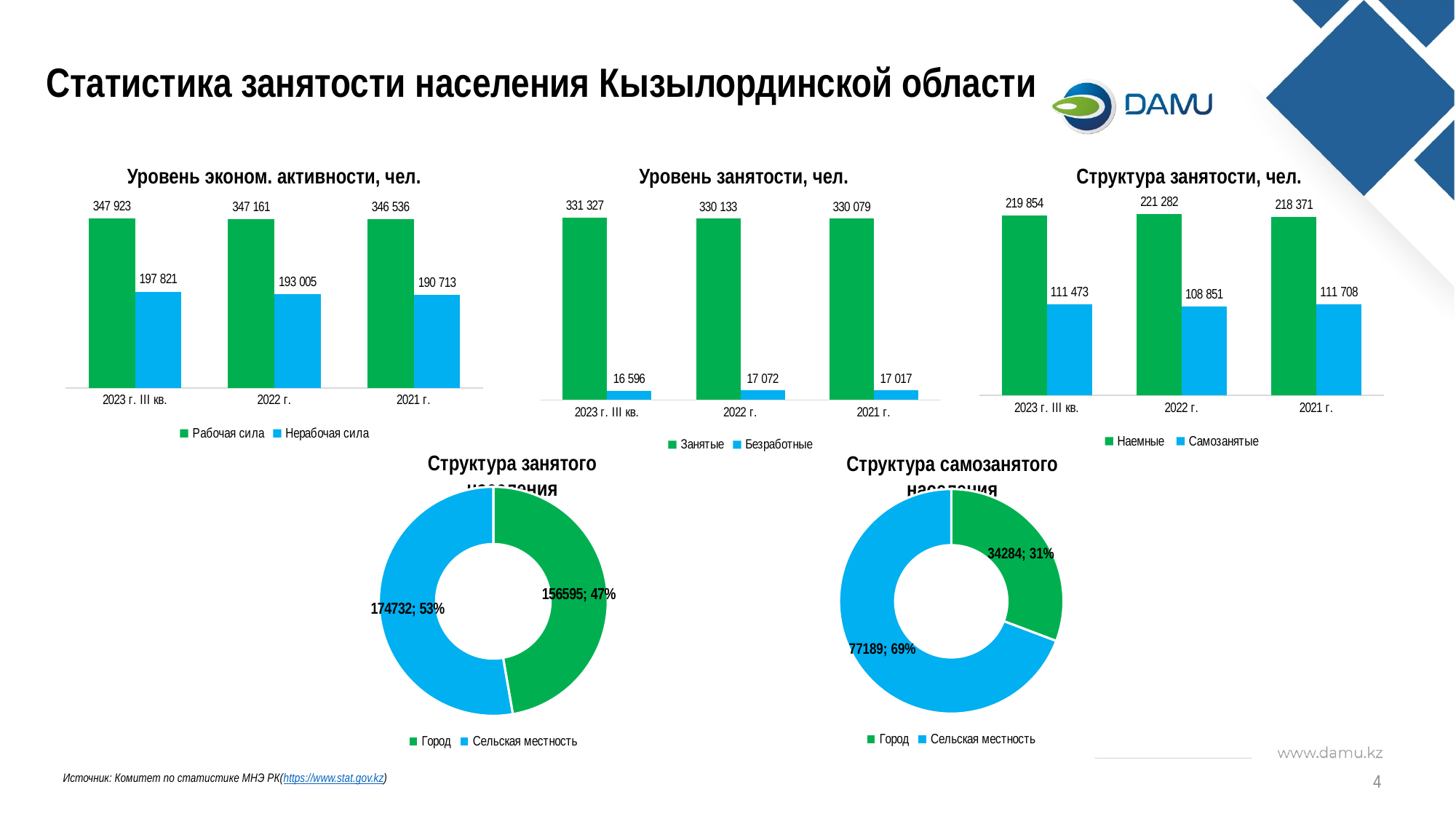
In the chart 'Уровень эконом. активности, чел.', what is the value of Нерабочая сила for 2021 г.? 190 713 In the chart 'Структура занятого населения', what is the value for Город? 156595 In the chart 'Структура занятости, чел.', what is the difference between Наемные and Самозанятые for 2021 г.? 106 663 In the chart 'Уровень занятости, чел.', how many periods are shown on the x axis? 3 What type of chart is 'Структура занятого населения'? Doughnut chart In the chart 'Уровень эконом. активности, чел.', what is the value of Рабочая сила for 2023 г. III кв.? 347 923 In the chart 'Уровень эконом. активности, чел.', how many series does the legend list? 2 In the chart 'Структура занятости, чел.', which is larger for 2022 г.: Наемные or Самозанятые? Наемные In the chart 'Уровень занятости, чел.', which period has the lowest value for Безработные? 2023 г. III кв. In the chart 'Структура занятости, чел.', which period has the highest value for Наемные? 2022 г. In the chart 'Уровень занятости, чел.', what is the value of Безработные for 2022 г.? 17 072 In the chart 'Структура самозанятого населения', what share does Сельская местность have? 69%